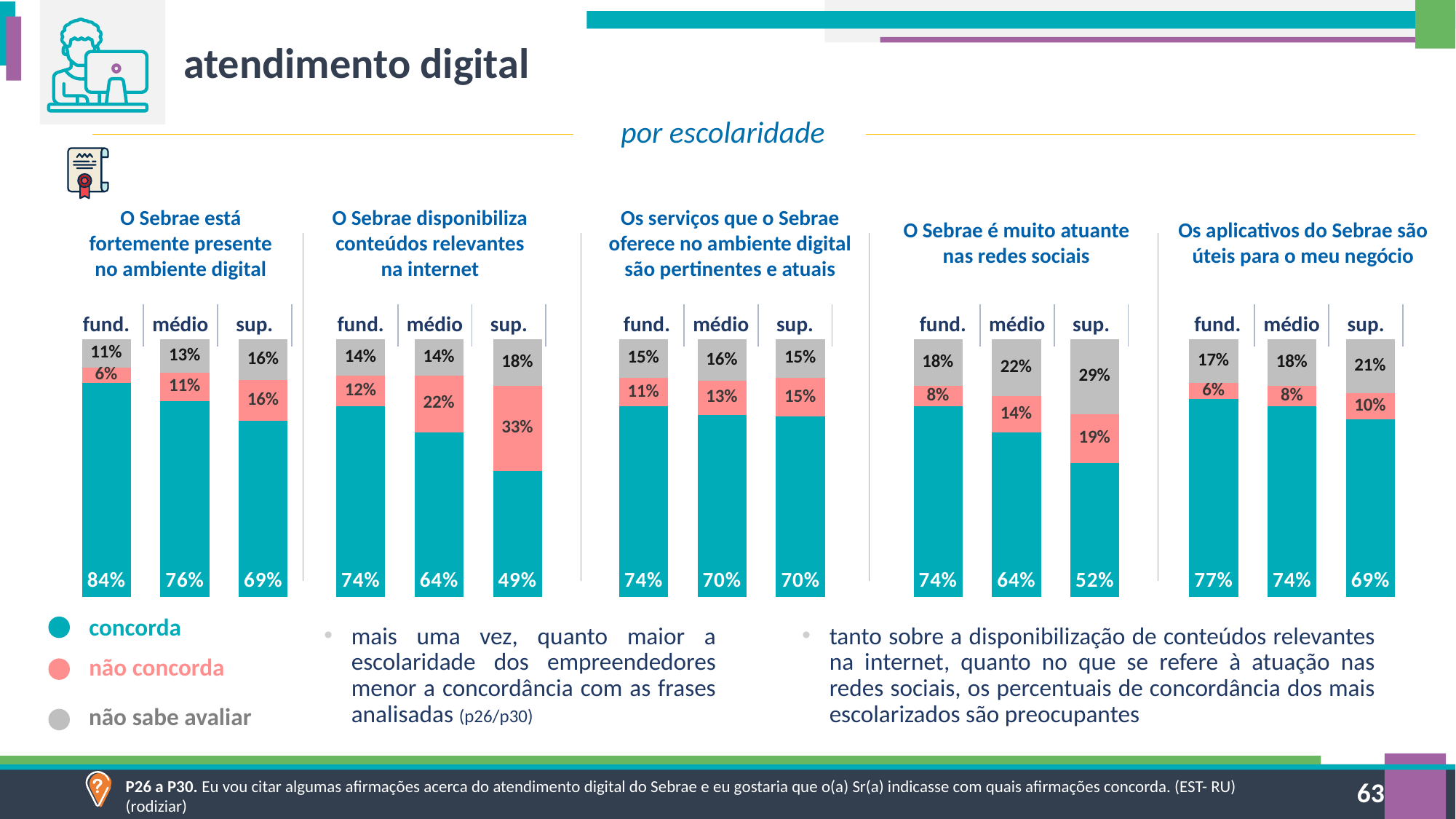
In the chart titled 'Os serviços que o Sebrae oferece no ambiente digital são pertinentes e atuais', is the 'não concorda' value larger for fund. or for sup.? sup. How many series does the legend list? 3 In the chart titled 'Os aplicativos do Sebrae são úteis para o meu negócio', which education level has the highest 'concorda' value? fund. In the chart titled 'O Sebrae é muito atuante nas redes sociais', what is the difference between the 'concorda' values for fund. and sup.? 22 percentage points In the chart titled 'O Sebrae é muito atuante nas redes sociais', do the 'concorda' values rise or fall from fund. to sup.? Fall In the chart titled 'O Sebrae está fortemente presente no ambiente digital', what is the 'concorda' value for fund.? 84% What kind of chart is used on this slide? Stacked bar chart In the chart titled 'O Sebrae é muito atuante nas redes sociais', what is the 'não sabe avaliar' value for sup.? 29% How many education-level categories does each chart on the slide show? 3 In the chart titled 'O Sebrae disponibiliza conteúdos relevantes na internet', what is the total of the stacked bar for fund.? 100% In the chart titled 'O Sebrae disponibiliza conteúdos relevantes na internet', which education level has the lowest 'concorda' value? sup. In the chart titled 'O Sebrae disponibiliza conteúdos relevantes na internet', what is the 'não concorda' value for sup.? 33%